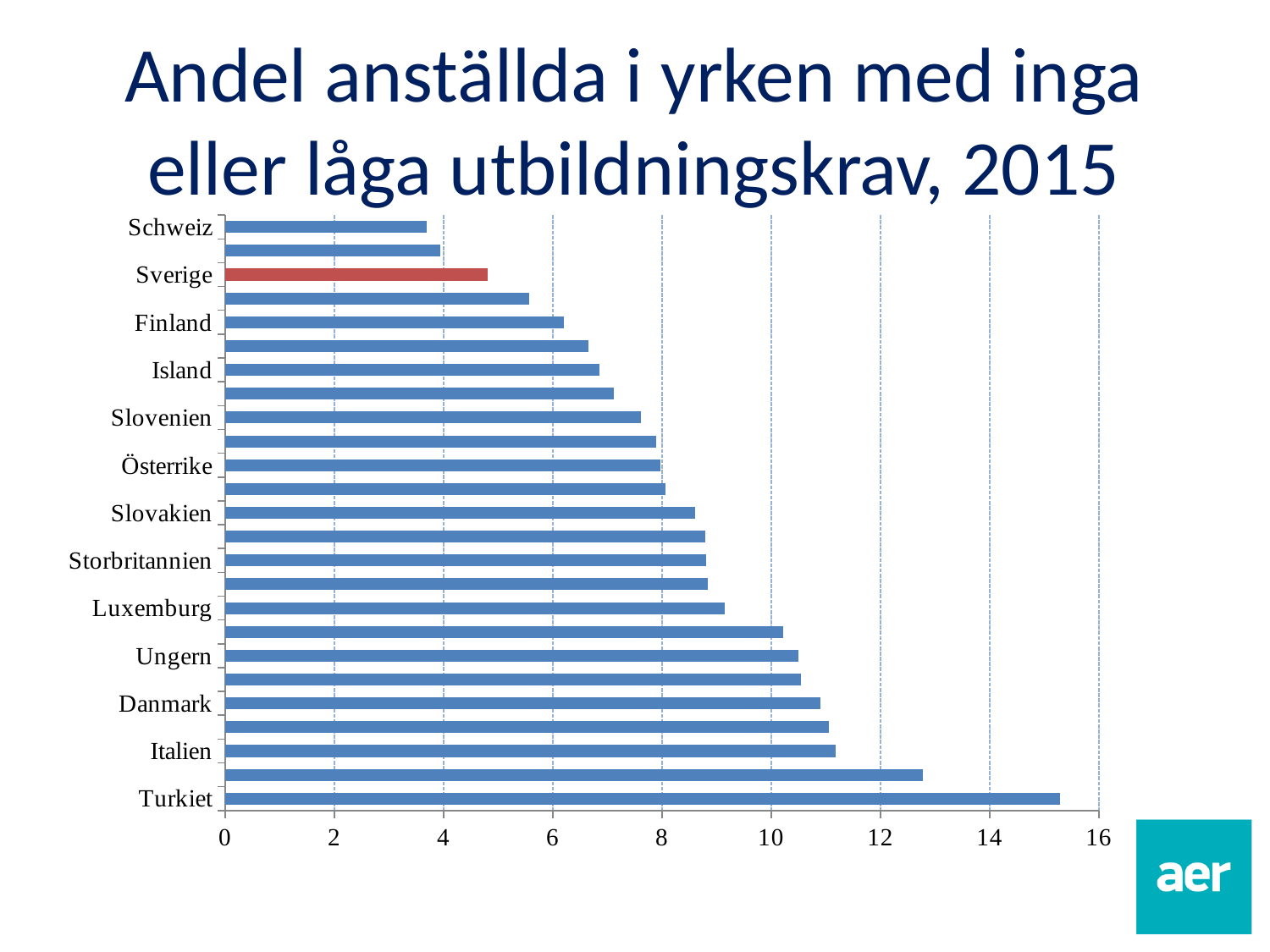
Is the value for Schweiz greater or less than 4? less Is the value for Sverige greater or less than 6? less Which country has the highest value in the chart? Turkiet Which country's bar is highlighted in red? Sverige Is the value for Slovenien greater or less than 8? less Which country has the lowest value in the chart? Schweiz What kind of chart is shown on the slide? bar chart Which has the larger value, Danmark or Finland? Danmark Which has the larger value, Sverige or Italien? Italien